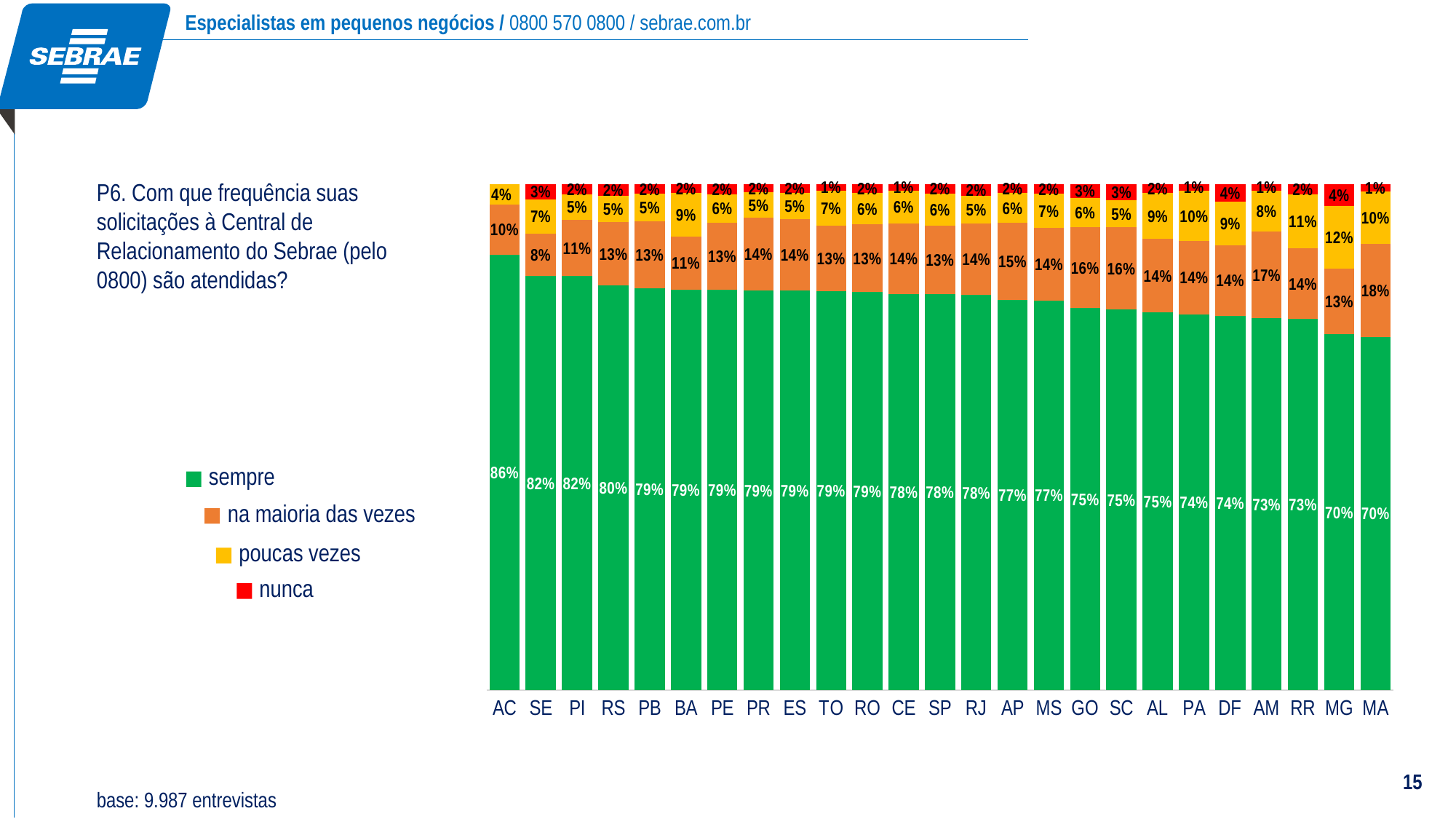
Which state has the highest "na maioria das vezes" value? MA Which is larger, the "poucas vezes" value for RR or for AM? RR What kind of chart is shown on the slide? Stacked bar chart What is the "nunca" value for DF? 4% How many series does the legend list? 4 What is the "poucas vezes" value for MG? 12% Which state has the highest "sempre" value? AC What is the difference between the "sempre" values for AC and MA? 16 percentage points How many states are shown on the x axis? 25 What percentage of respondents in AC answered "sempre"? 86% What is the "na maioria das vezes" value for MA? 18% Which colour represents "nunca" in the legend? Red